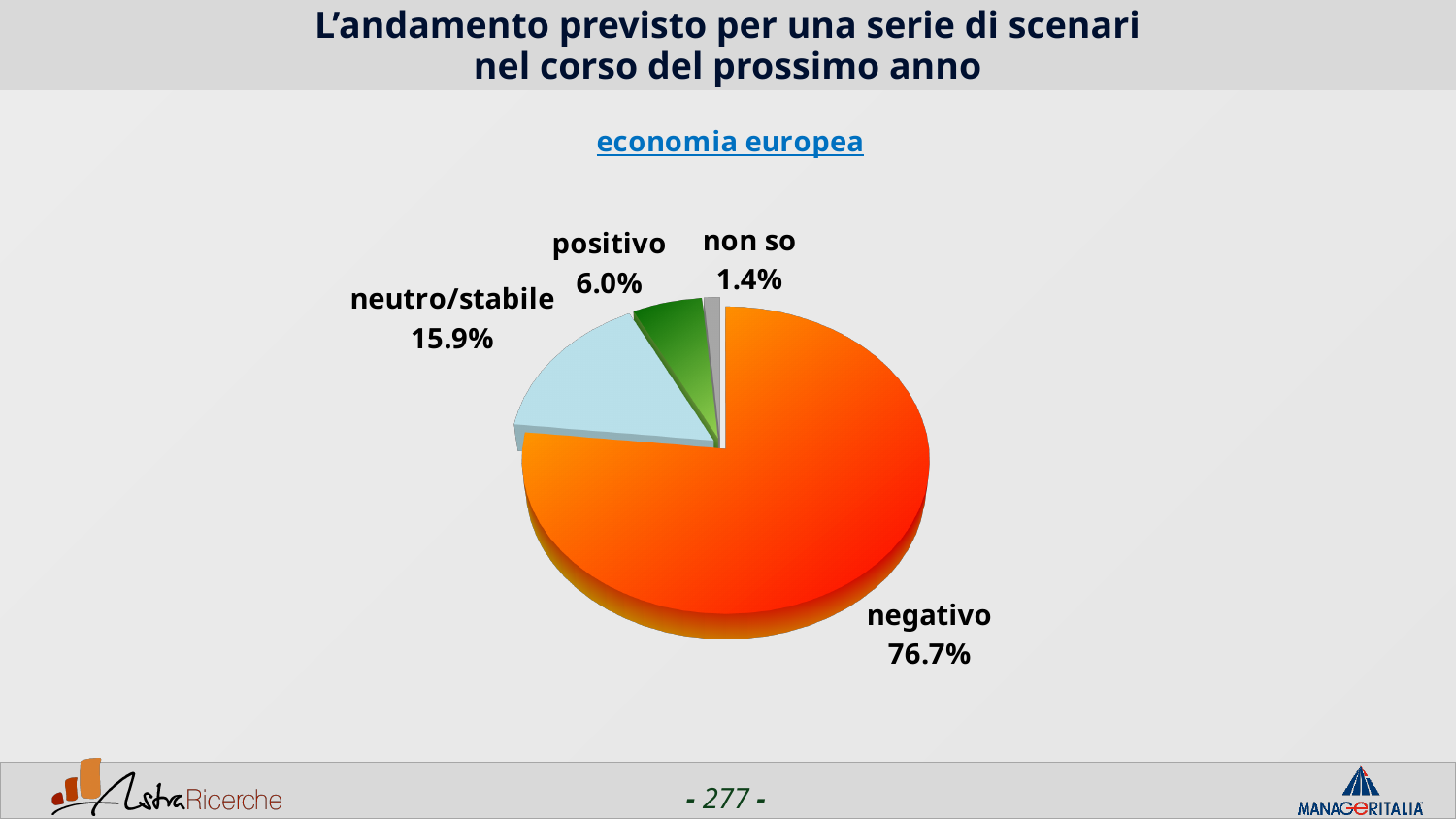
What share of the pie is labelled 'negativo'? 76.7% Which category has the largest slice of the pie? negativo What is the difference between the 'positivo' and 'non so' values? 4.6% What kind of chart is shown on the slide? pie chart Which is larger, 'neutro/stabile' or 'positivo'? neutro/stabile What is the subtitle shown above the chart? economia europea What is the value for 'non so'? 1.4% How many categories are shown in the pie chart? 4 What is the value for 'positivo'? 6.0% What is the value for 'neutro/stabile'? 15.9% Which category has the smallest slice of the pie? non so What is the difference between the 'negativo' and 'neutro/stabile' values? 60.8%